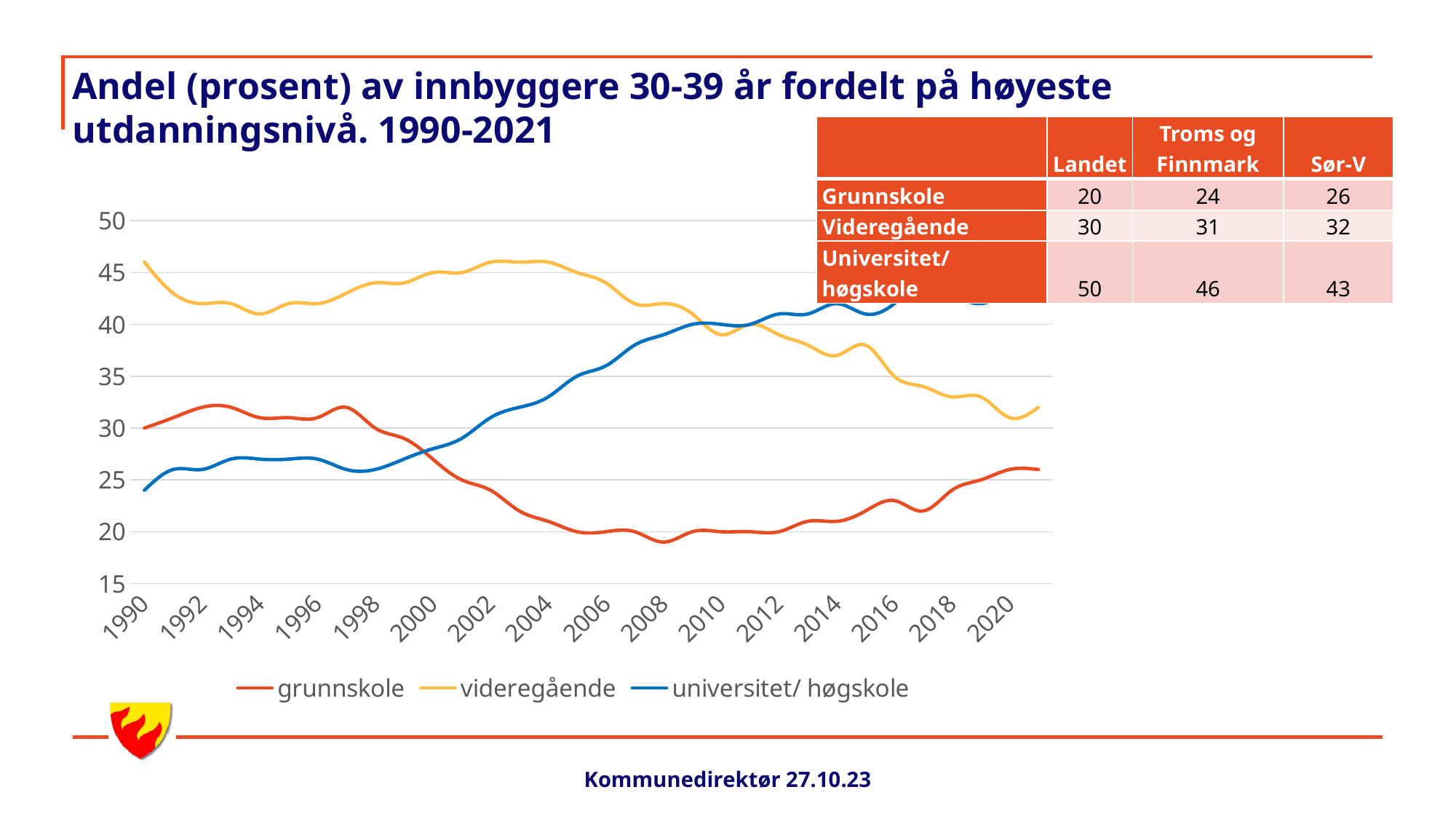
What are the three series named in the chart's legend? grunnskole, videregående, universitet/ høgskole Is the value for universitet/ høgskole in 1990 greater or less than 30? less Which series has the lowest value in 1990? universitet/ høgskole What kind of chart is shown on the slide? line chart How many series does the chart's legend list? 3 Does the grunnskole line rise or fall between 1998 and 2008? fall What colour is the universitet/ høgskole line in the chart? blue Does the universitet/ høgskole line rise or fall from 1990 to 2021? rise In 2020, which series has the higher value: grunnskole or videregående? videregående Is the value for videregående in 2004 greater or less than 40? greater Is the value for grunnskole in 2008 greater or less than 25? less